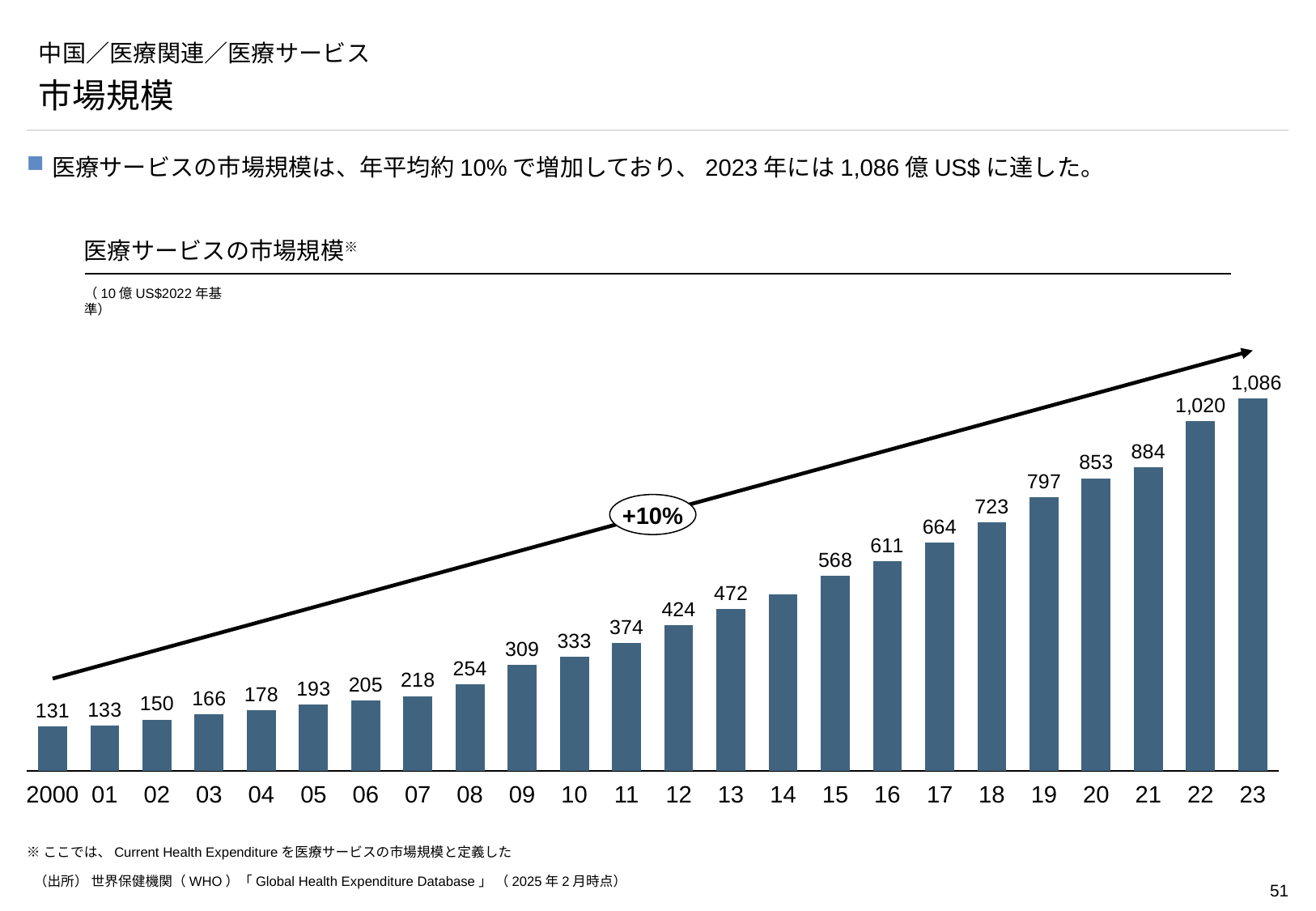
Which is larger, the value for 2016 or the value for 2017? 2017 Which year has the lowest value? 2000 What is the value for 2023? 1,086 What is the value for 2000? 131 What kind of chart is this? Bar chart What is the value for 2019? 797 Do the values rise or fall from 2000 to 2023? Rise What is the difference between the values for 2010 and 2000? 202 What is the difference between the values for 2023 and 2022? 66 How many years (bars) are shown in the chart? 24 Which year has the highest value? 2023 What is the value for 2012? 424